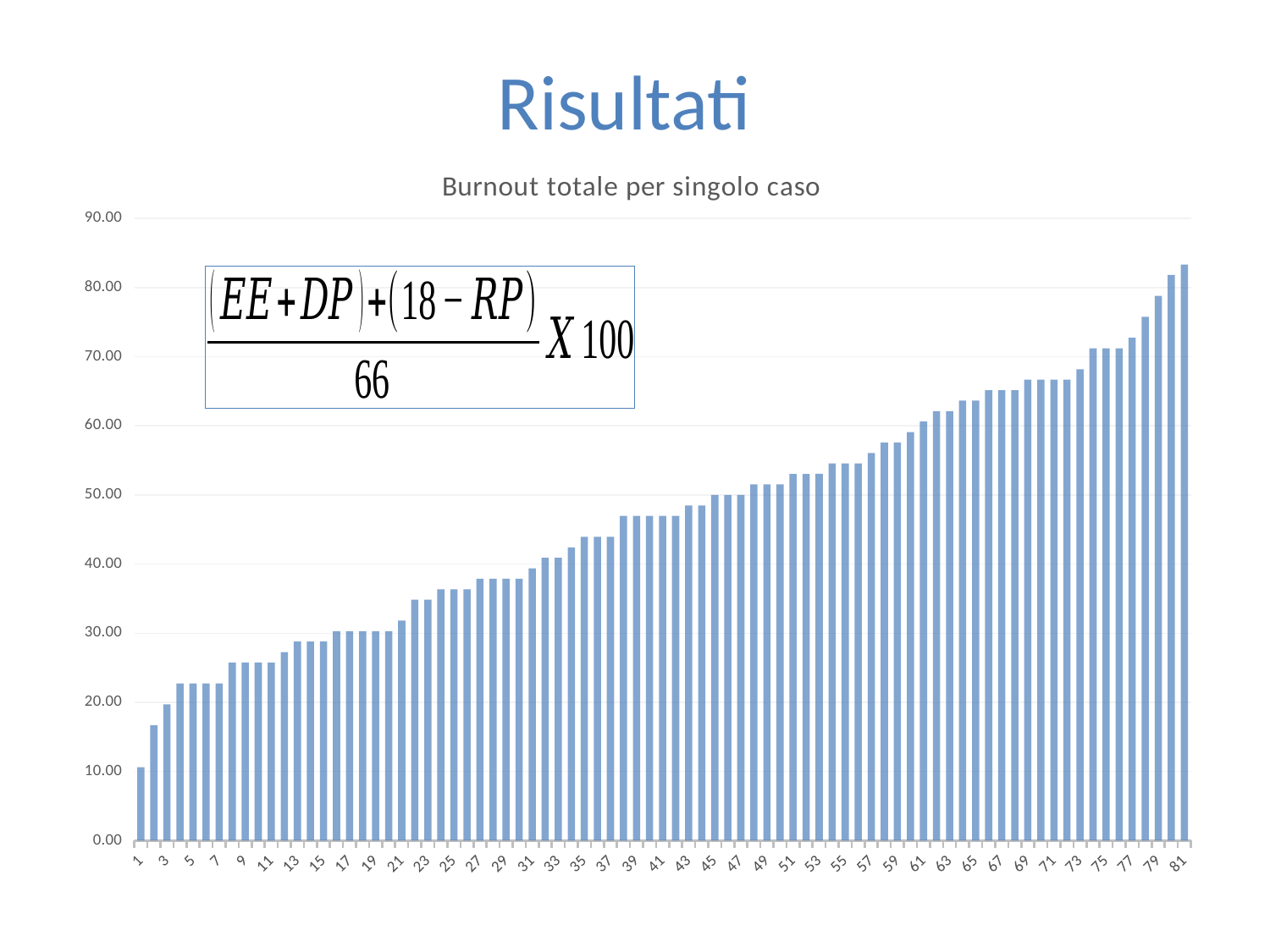
Is the value for case 81 greater or less than 80.00? greater What kind of chart is shown on the slide? bar chart How many cases (bars) are plotted in the chart? 81 Which has the larger value, case 31 or case 51? case 51 Which case has the lowest burnout value? 1 What is the highest value shown on the y axis? 90.00 Is the value for case 1 greater or less than 20.00? less Is the value for case 71 greater or less than 60.00? greater What is the title of the chart? Burnout totale per singolo caso Which case has the highest burnout value? 81 Do the values rise or fall as the case number increases along the x axis? rise